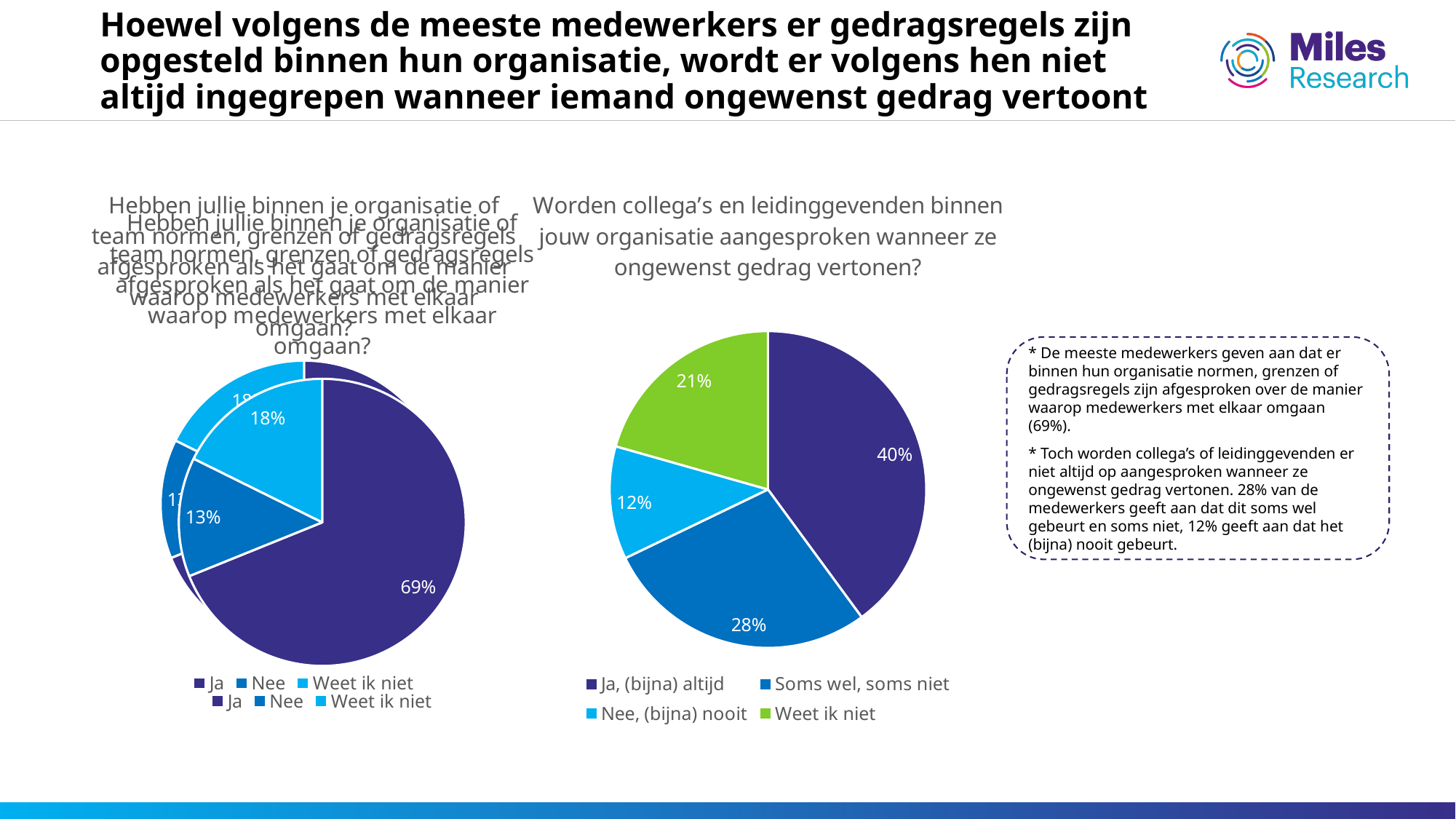
In the right pie chart, what percentage is shown for 'Ja, (bijna) altijd'? 40% In the left pie chart, what percentage is shown for 'Weet ik niet'? 18% How many categories does the legend of the right pie chart list? 4 In the right pie chart, what percentage is shown for 'Soms wel, soms niet'? 28% In the right pie chart, what is the difference in percentage points between 'Ja, (bijna) altijd' and 'Soms wel, soms niet'? 12 In the left pie chart, which category has the largest share? Ja What type of chart is used on the right side of the slide? Pie chart In the right pie chart, which category has the smallest share? Nee, (bijna) nooit In the right pie chart, what percentage is shown for 'Nee, (bijna) nooit'? 12% In the left pie chart, what percentage is shown for 'Ja'? 69% In the left pie chart, what percentage is shown for 'Nee'? 13% In the left pie chart, which category has the smallest share? Nee